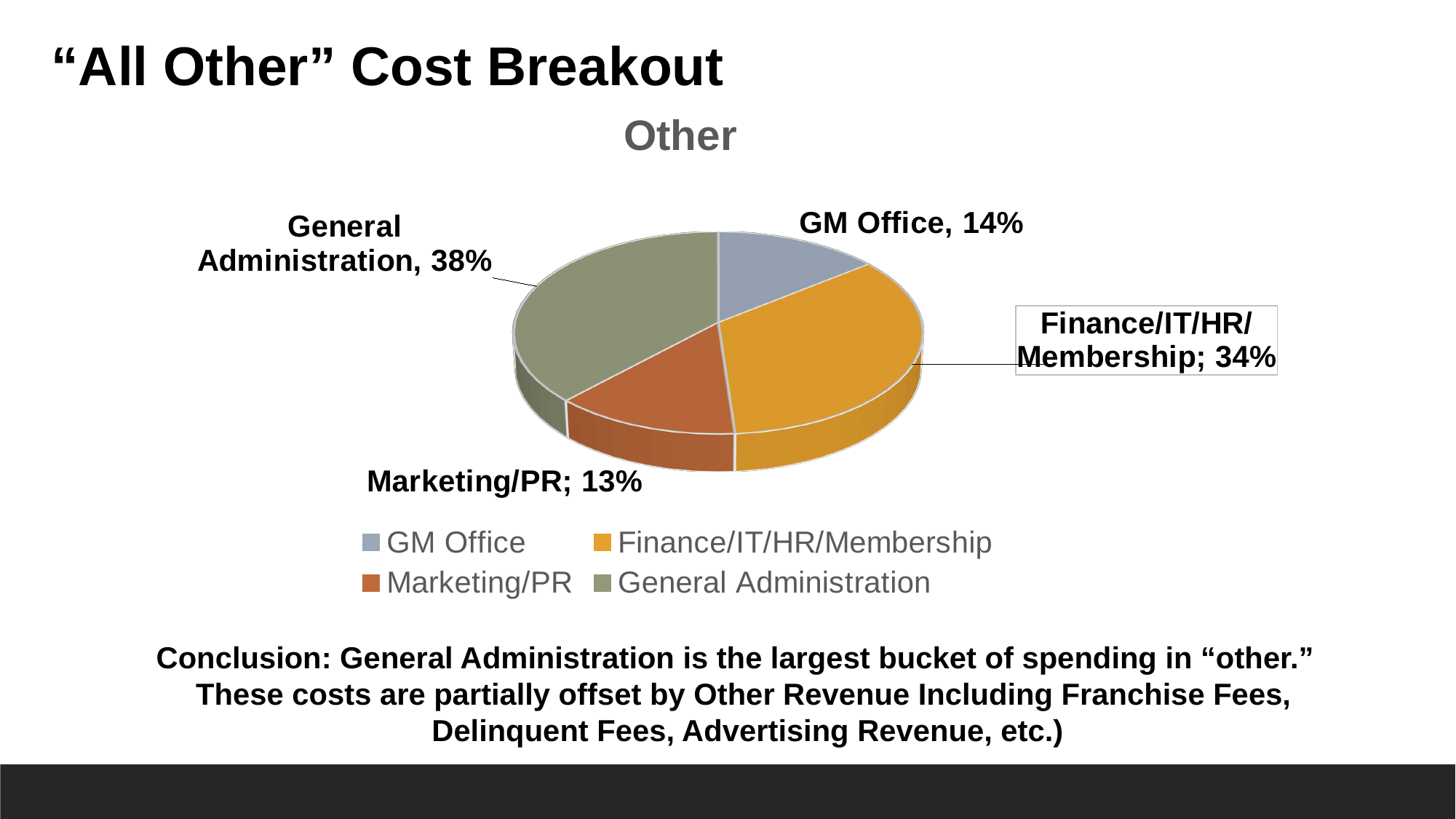
Which category has the largest slice of the pie? General Administration What share of the pie does General Administration account for? 38% What is the difference in percentage points between Finance/IT/HR/Membership and Marketing/PR? 21 What share of the pie does Finance/IT/HR/Membership account for? 34% What kind of chart is shown on the slide? Pie chart What is the value shown for Marketing/PR? 13% How many categories are shown in the pie chart? 4 Which category has the smallest slice of the pie? Marketing/PR What is the value shown for GM Office? 14% What is the title of the chart? Other What is the difference in percentage points between General Administration and GM Office? 24 Which is larger, the General Administration slice or the Finance/IT/HR/Membership slice? General Administration